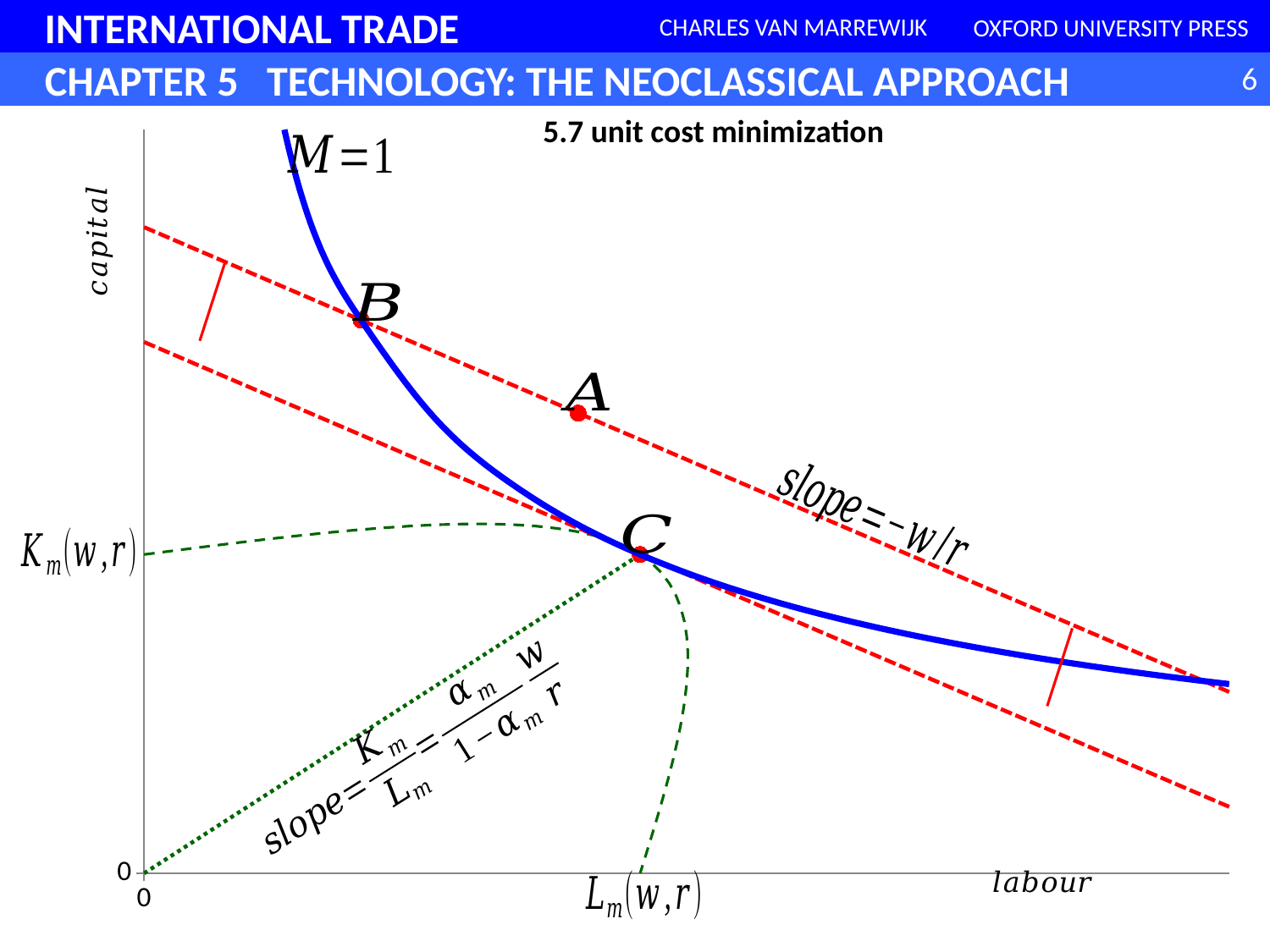
Which labeled point on the chart has the lowest capital value? C Which of points A and B has the larger labour value? A Which labeled point on the chart has the lowest labour value? B Which labeled point on the chart has the highest capital value? B What is the title of the chart on the slide? 5.7 unit cost minimization What are the labels of the vertical and horizontal axes of the chart? capital (vertical) and labour (horizontal) Does the blue M=1 curve rise or fall as labour increases along the x axis? fall Which labeled point on the chart has the highest labour value? C What kind of chart is shown on the slide? line chart Which labeled point does not lie on the blue M=1 curve? A How many labeled points (marked with letters) are shown on the chart? 3 Which of points A and C has the larger capital value? A